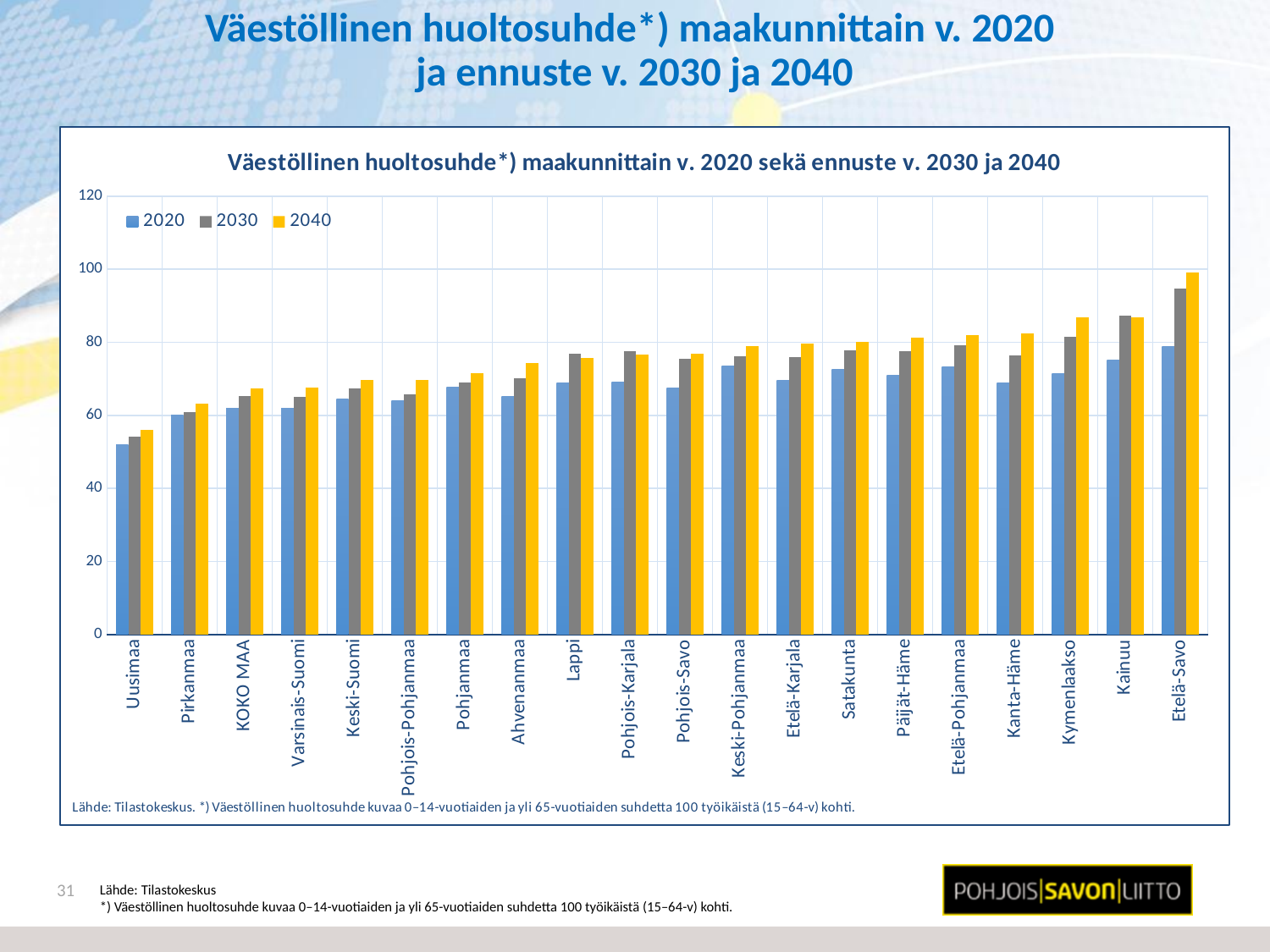
Is the 2030 value for Kainuu greater or less than 80? greater How many regions (categories) are shown on the x axis? 20 Which colour represents the 2040 series in the legend? yellow Which region has the lowest value for the 2020 series? Uusimaa Do the 2040 values generally rise or fall moving from left to right along the x axis? rise Which region has the lowest value for the 2040 series? Uusimaa How many series does the legend list? 3 Is the 2040 value for Etelä-Savo greater or less than 80? greater Which region has the highest value for the 2040 series? Etelä-Savo Which is larger: the 2040 value for Etelä-Savo or the 2040 value for Kainuu? Etelä-Savo Is the 2020 value for Uusimaa greater or less than 60? less What kind of chart is shown on the slide? bar chart